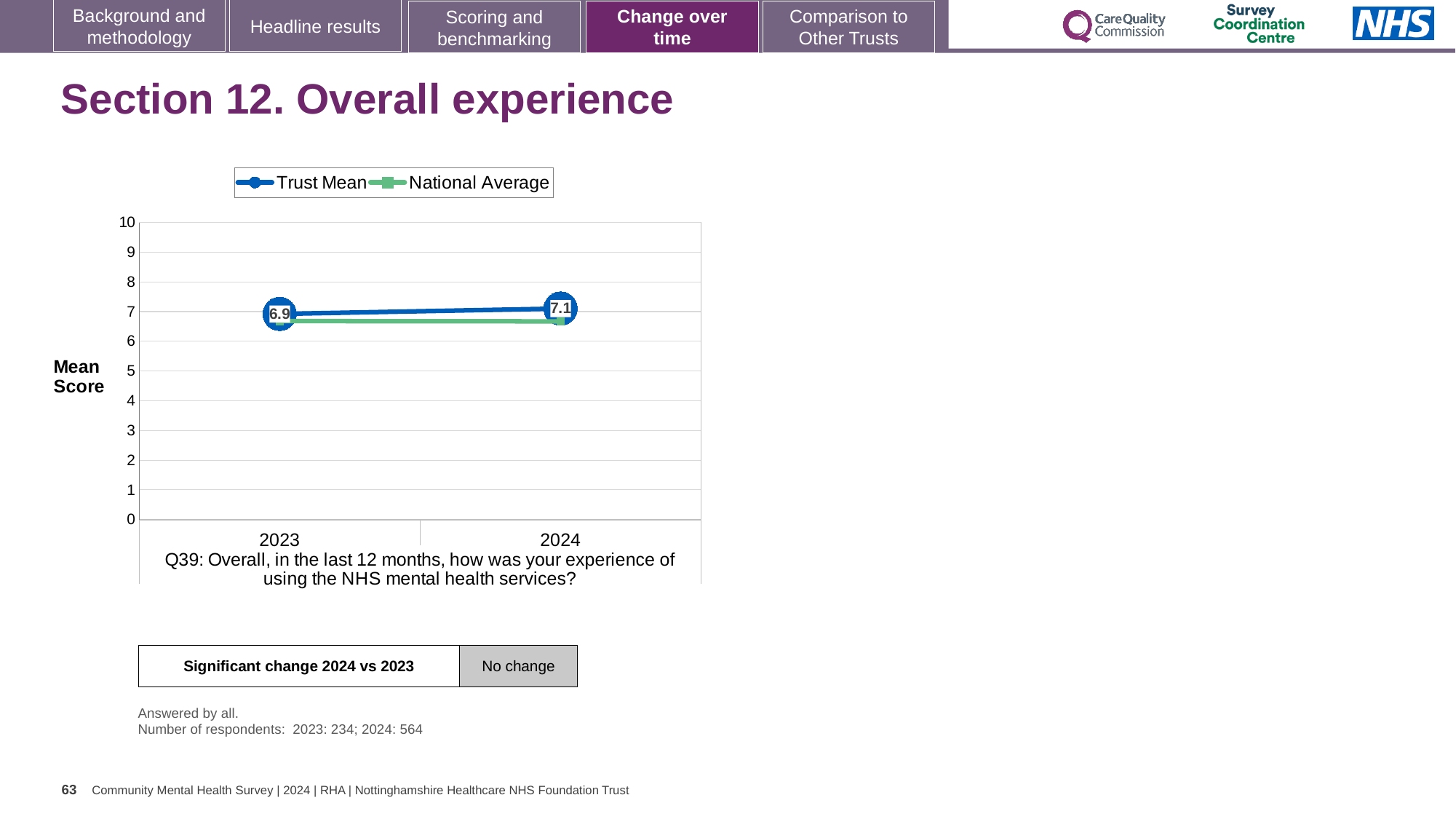
What is the label on the y axis of the chart? Mean Score What kind of chart is shown on the slide? line chart Is the National Average value for 2023 greater or less than 7? less In 2024, which is larger: the Trust Mean or the National Average? Trust Mean What is the difference between the Trust Mean in 2024 and in 2023? 0.2 In which year is the Trust Mean highest? 2024 Does the Trust Mean rise or fall from 2023 to 2024? rise What is the Trust Mean value for 2024? 7.1 What is the Trust Mean value for 2023? 6.9 In which year is the Trust Mean lowest? 2023 How many years are shown on the x axis of the chart? 2 How many series does the chart legend list? 2